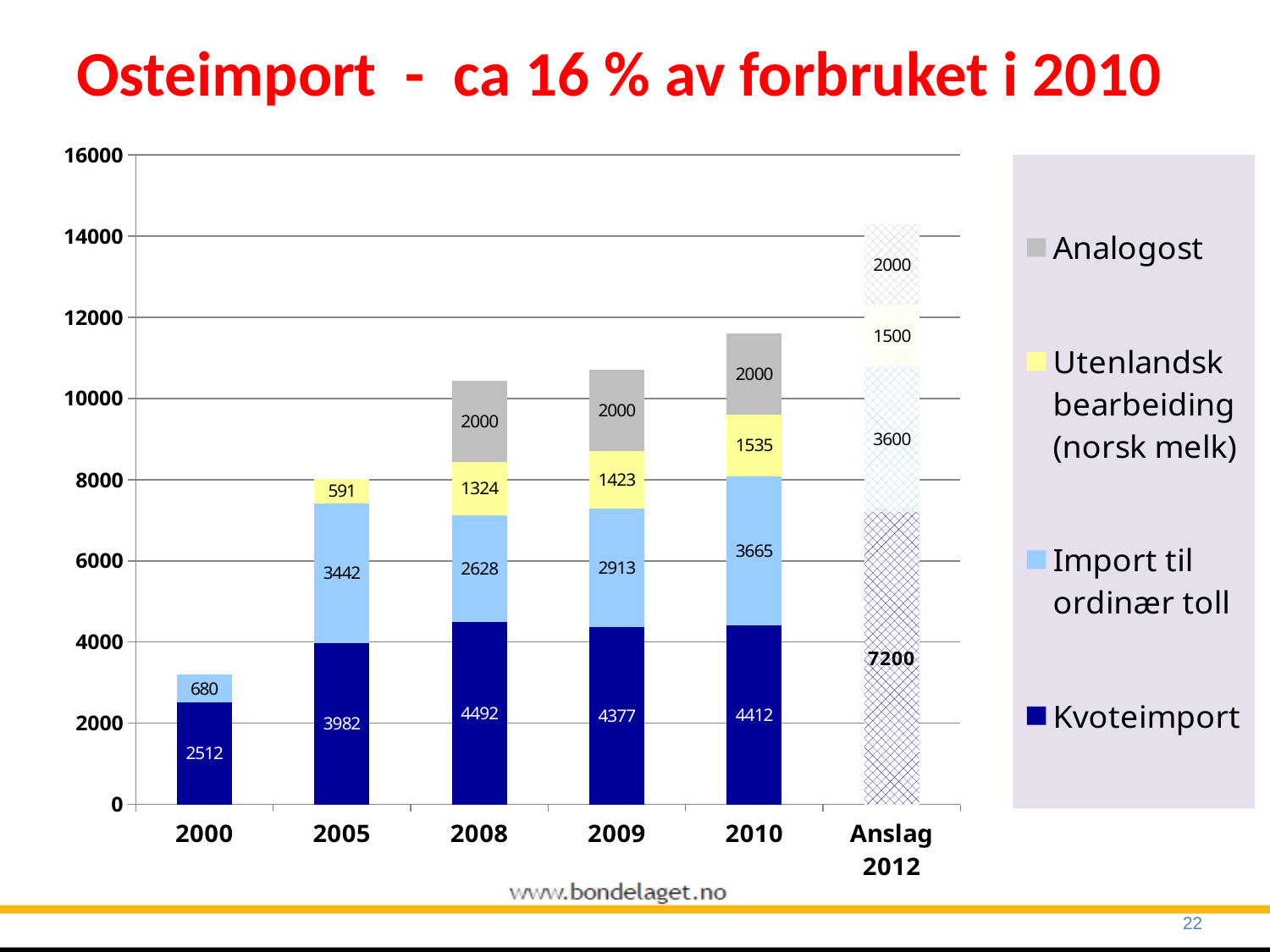
What is the Utenlandsk bearbeiding (norsk melk) value for 2009? 1423 Which is larger, the Import til ordinær toll value for 2008 or for 2009? 2009 What is the Import til ordinær toll value for 2005? 3442 What is the Kvoteimport value for Anslag 2012? 7200 Which category has the lowest Import til ordinær toll value? 2000 How many series does the legend list? 4 What kind of chart is shown on the slide? Stacked bar chart Which category has the highest Kvoteimport value? Anslag 2012 What is the difference between the Kvoteimport values for 2008 and 2009? 115 What is the Kvoteimport value for 2010? 4412 What is the total of the stacked bar for 2010? 11612 What is the total of the stacked bar for 2000? 3192